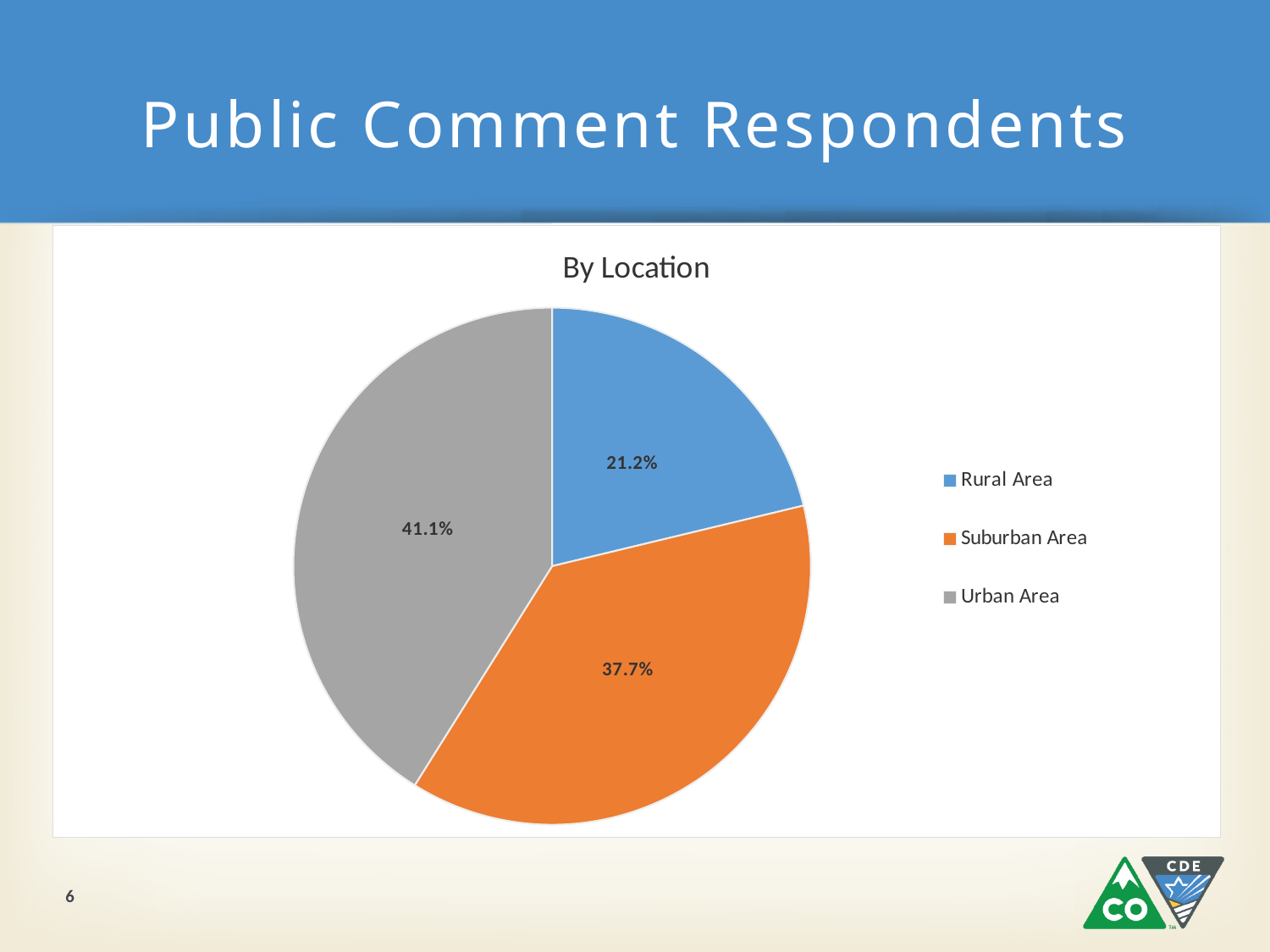
What is the difference in percentage points between the Urban Area and Rural Area shares? 19.9 How many categories does the pie chart show? 3 Which location category has the largest share of respondents? Urban Area What percentage of respondents are from a Rural Area? 21.2% What is the title of the chart? By Location Which is larger, the Suburban Area share or the Rural Area share? Suburban Area What is the difference in percentage points between the Suburban Area and Rural Area shares? 16.5 What colour represents the Suburban Area slice? orange What percentage of respondents are from a Suburban Area? 37.7% What percentage of respondents are from an Urban Area? 41.1% Which location category has the smallest share of respondents? Rural Area What type of chart is shown on the slide? pie chart